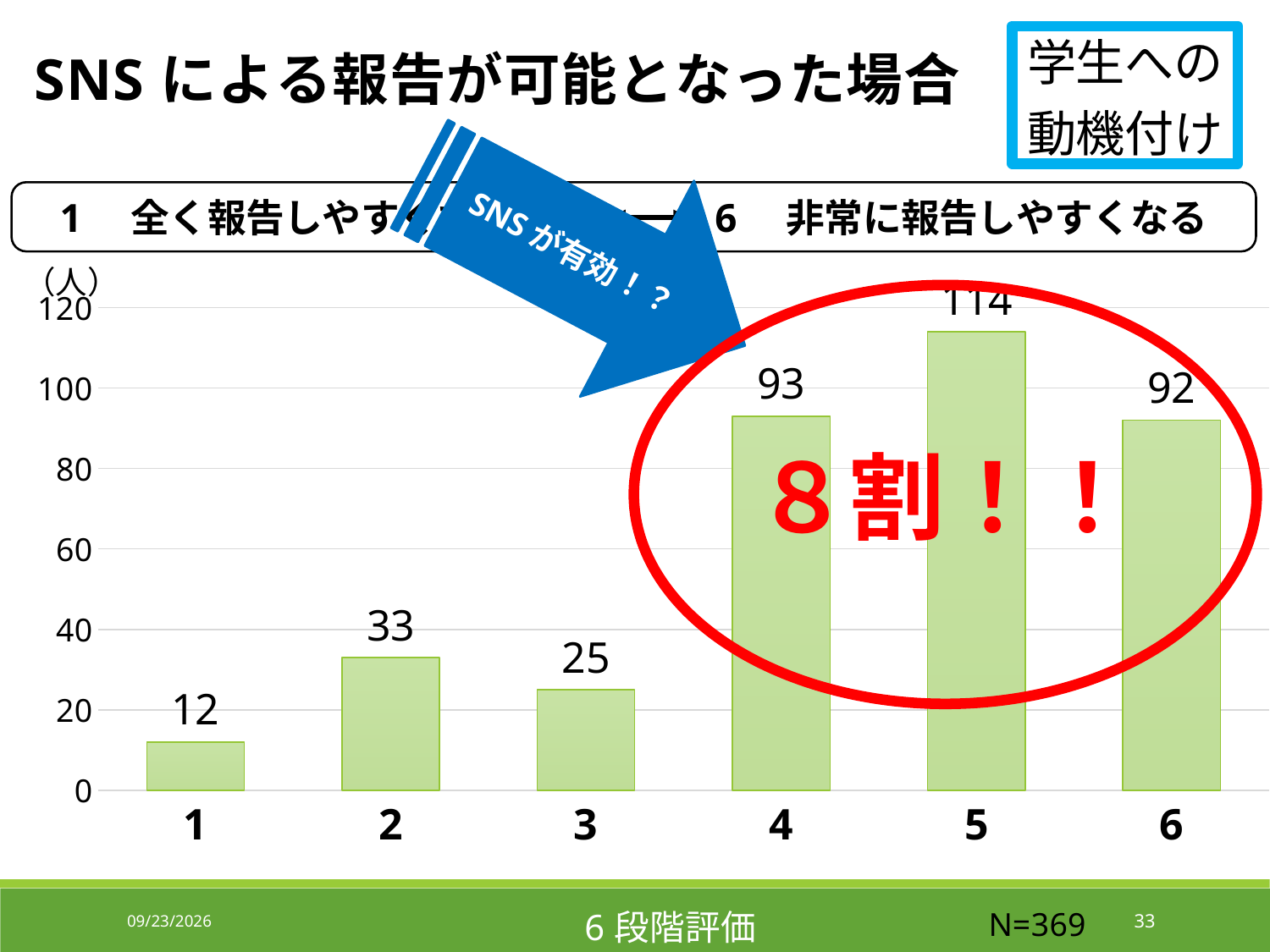
What kind of chart is shown on the slide? bar chart Which is larger, the value for category 4 or category 6? 4 What is the difference between the values for category 2 and category 1? 21 What is the value for category 1? 12 What is the value for category 5? 114 Which category has the highest value? 5 What is the difference between the values for category 5 and category 4? 21 How many categories are shown on the x axis? 6 Which category has the lowest value? 1 What is the unit label shown at the top of the y axis? （人） Is the value for category 5 greater or less than 100? greater What is the value for category 3? 25